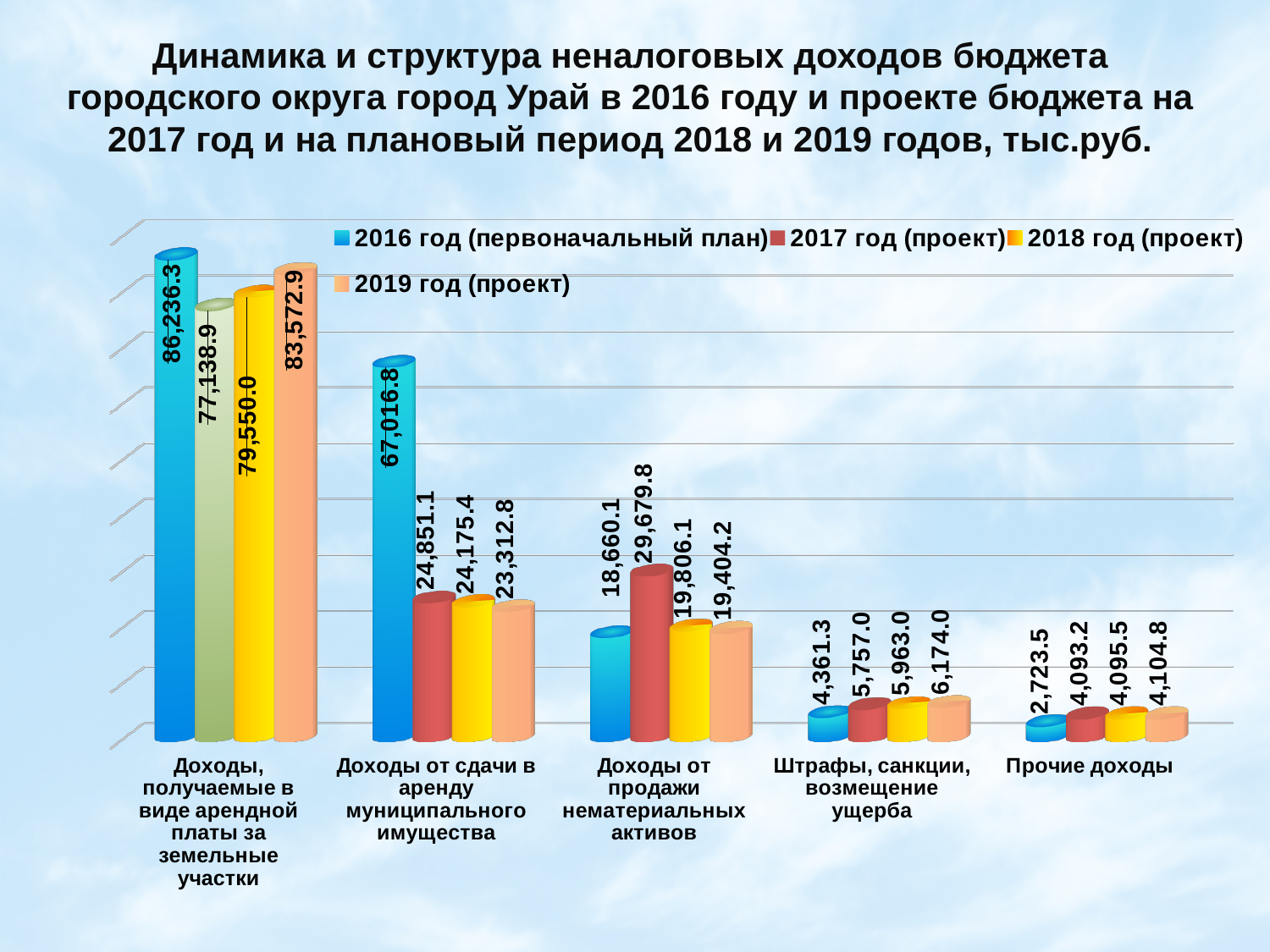
Which category has the highest value in the series '2016 год (первоначальный план)'? Доходы, получаемые в виде арендной платы за земельные участки What is the value for 'Доходы от сдачи в аренду муниципального имущества' in the series '2016 год (первоначальный план)'? 67,016.8 What is the value for 'Прочие доходы' in the series '2017 год (проект)'? 4,093.2 How many series does the legend list? 4 What is the difference between the 2017 and 2016 values for 'Доходы от продажи нематериальных активов'? 11,019.7 What type of chart is shown on the slide? bar chart How many categories are shown on the x axis? 5 What is the difference between the 2016 and 2017 values for 'Доходы, получаемые в виде арендной платы за земельные участки'? 9,097.4 Which series in the legend is shown in blue? 2016 год (первоначальный план) For 'Доходы от продажи нематериальных активов', which is larger: the value for '2017 год (проект)' or for '2018 год (проект)'? 2017 год (проект) Which category has the lowest value in the series '2018 год (проект)'? Прочие доходы What is the value for 'Штрафы, санкции, возмещение ущерба' in the series '2019 год (проект)'? 6,174.0